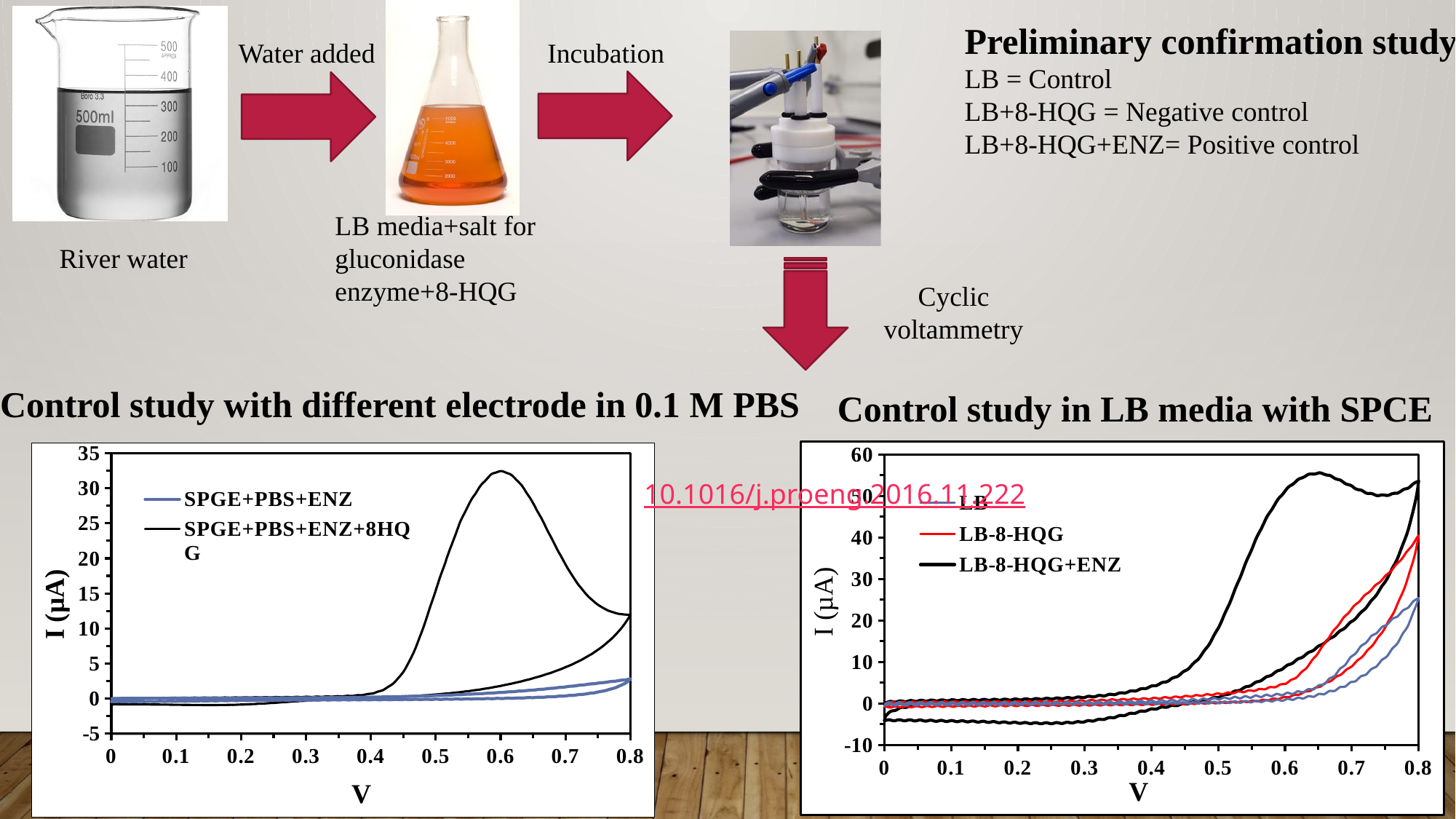
In the 'Control study in LB media with SPCE' chart, is the peak current of LB-8-HQG+ENZ greater or less than 50? greater In the 'Control study in LB media with SPCE' chart, what colour is the LB-8-HQG line? red In the 'Control study with different electrode in 0.1 M PBS' chart, is the current for SPGE+PBS+ENZ at 0.8 V greater or less than 5? less In the 'Control study in LB media with SPCE' chart, at 0.8 V, which has the larger current: LB-8-HQG or LB? LB-8-HQG In the 'Control study with different electrode in 0.1 M PBS' chart, is the peak current of SPGE+PBS+ENZ+8HQG greater or less than 25? greater How many series does the legend of the 'Control study with different electrode in 0.1 M PBS' chart list? 2 What kind of chart is the 'Control study with different electrode in 0.1 M PBS' chart? line chart In the 'Control study with different electrode in 0.1 M PBS' chart, what is the label of the y axis? I (µA) In the 'Control study in LB media with SPCE' chart, which series reaches the highest current? LB-8-HQG+ENZ How many series does the legend of the 'Control study in LB media with SPCE' chart list? 3 In the 'Control study with different electrode in 0.1 M PBS' chart, which series reaches the highest current? SPGE+PBS+ENZ+8HQG